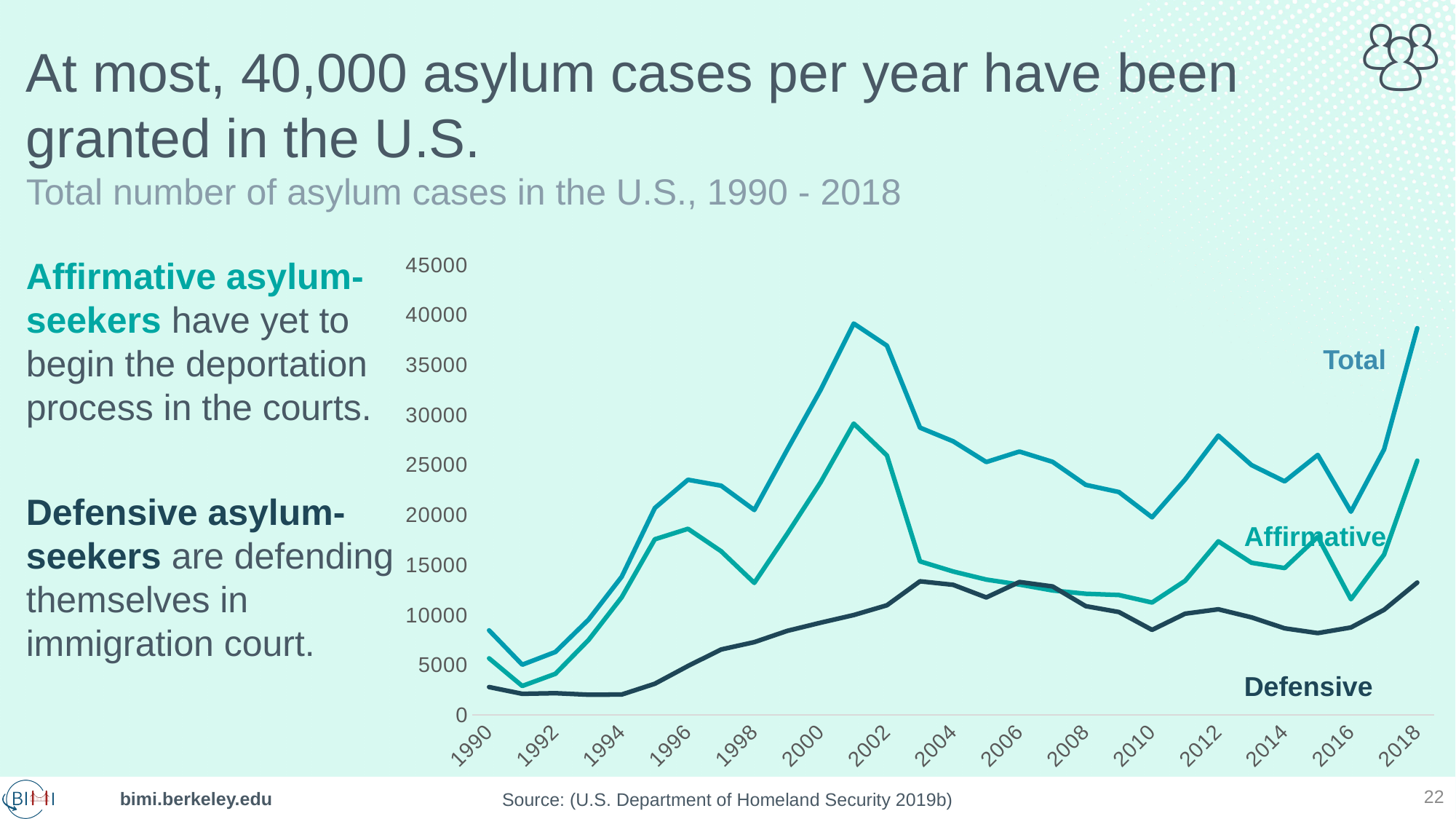
In 2016, which is larger: the Affirmative value or the Defensive value? Affirmative Is the value of the Defensive line in 1990 greater or less than 5000? less Is the value of the Affirmative line in 1990 greater or less than 10000? less Is the value of the Total line in 2001 greater or less than 35000? greater What are the names of the three lines plotted on the chart? Total, Affirmative, Defensive How many year labels are shown on the x axis? 15 How many series (lines) are plotted on the chart? 3 What kind of chart is shown on the slide? line chart Which line has the highest value in 2018? Total Does the Total line rise or fall between 2001 and 2010? fall